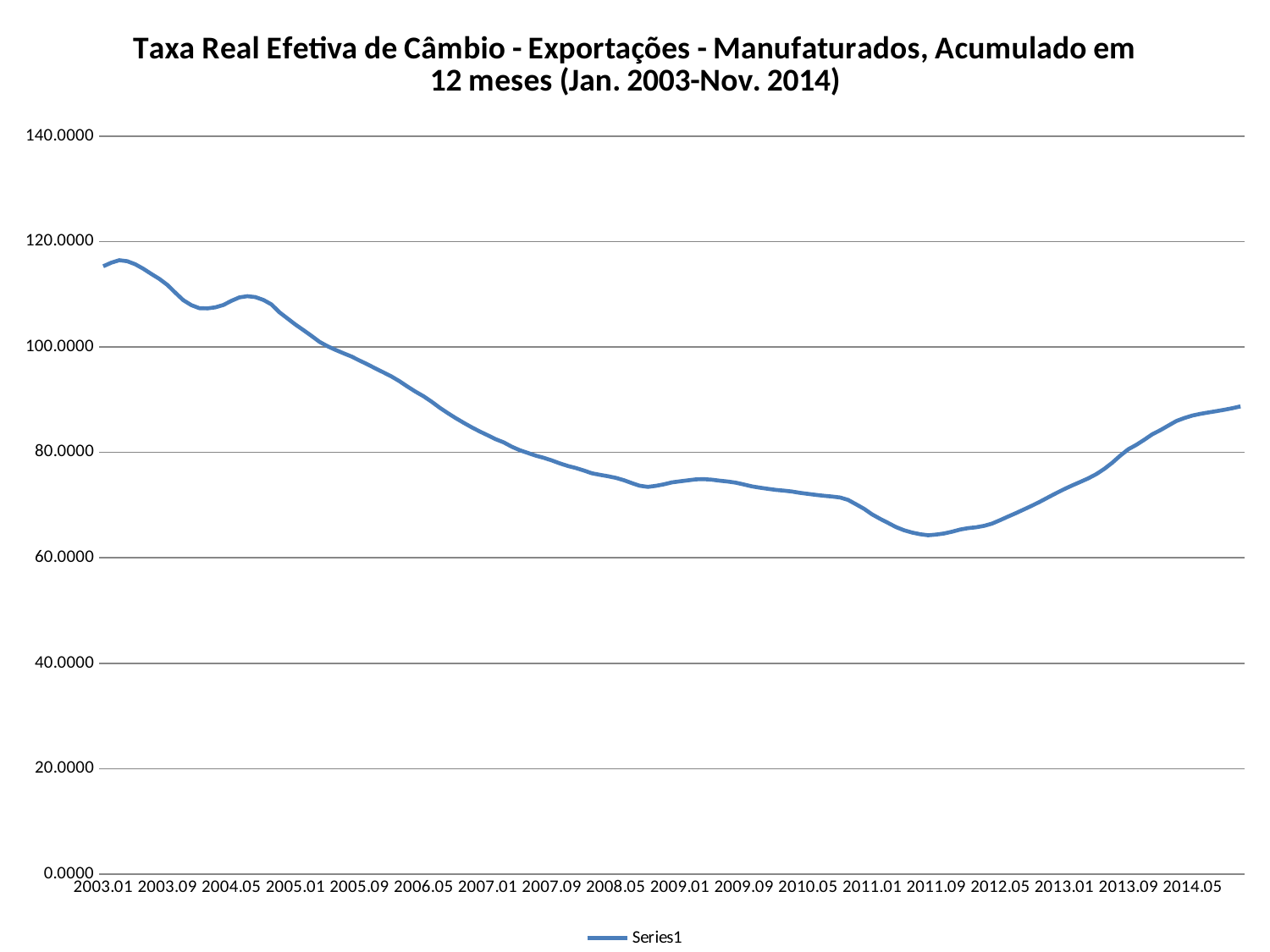
Which is larger, the value at 2003.01 or the value at 2014.05? 2003.01 Is the value at 2011.09 greater or less than 80? less What kind of chart is shown on the slide? line chart Is the value at 2003.01 greater or less than 100? greater What is the name of the series shown in the legend? Series1 Is the value at 2009.01 greater or less than 80? less Does the line rise or fall between 2003.01 and 2011.09? fall How many series does the legend list? 1 What period does the chart title say the data covers? Jan. 2003-Nov. 2014 At which labeled x-axis point is the line at its lowest? 2011.09